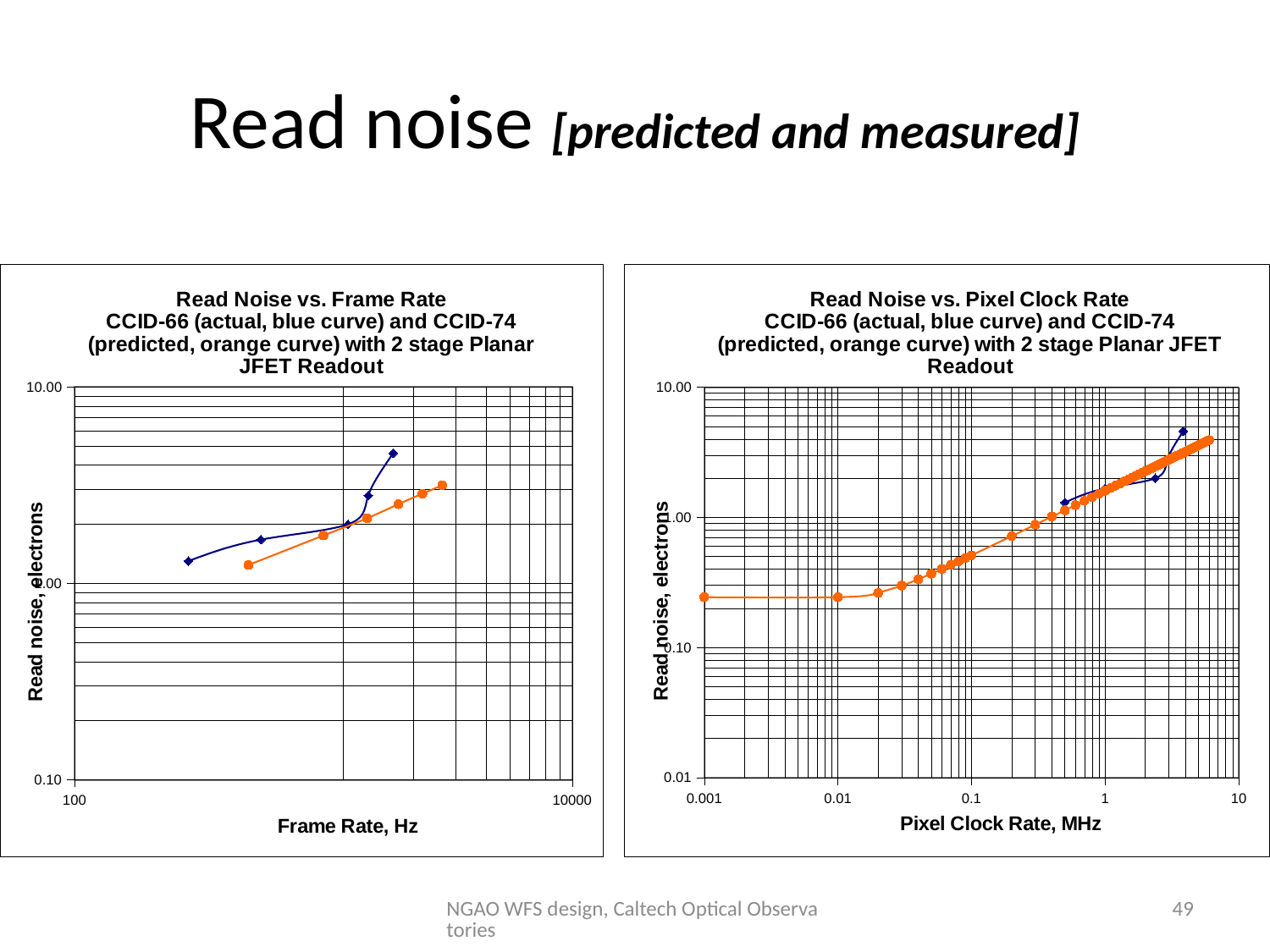
In the 'Read Noise vs. Frame Rate' chart, does the blue curve rise or fall as frame rate increases? Rise In the 'Read Noise vs. Frame Rate' chart, is the highest read noise value on the blue curve greater or less than 1.00 electrons? greater In the 'Read Noise vs. Pixel Clock Rate' chart, is the highest read noise value on the blue curve greater or less than 1.00 electrons? greater In the 'Read Noise vs. Pixel Clock Rate' chart, does the orange curve rise or fall as pixel clock rate increases from 0.1 MHz to 10 MHz? Rise How many data points are plotted on the blue curve in the 'Read Noise vs. Frame Rate' chart? 5 In the 'Read Noise vs. Pixel Clock Rate' chart, is the read noise of the orange curve at 0.001 MHz greater or less than 1.00 electrons? less What kind of chart is the 'Read Noise vs. Frame Rate' chart on the left? Line chart What is the x-axis title of the chart on the right? Pixel Clock Rate, MHz In the 'Read Noise vs. Frame Rate' chart, at the highest frame rate reached by the blue curve, which curve shows the higher read noise, blue or orange? Blue According to the title of the 'Read Noise vs. Frame Rate' chart, which detector does the orange curve represent? CCID-74 (predicted)